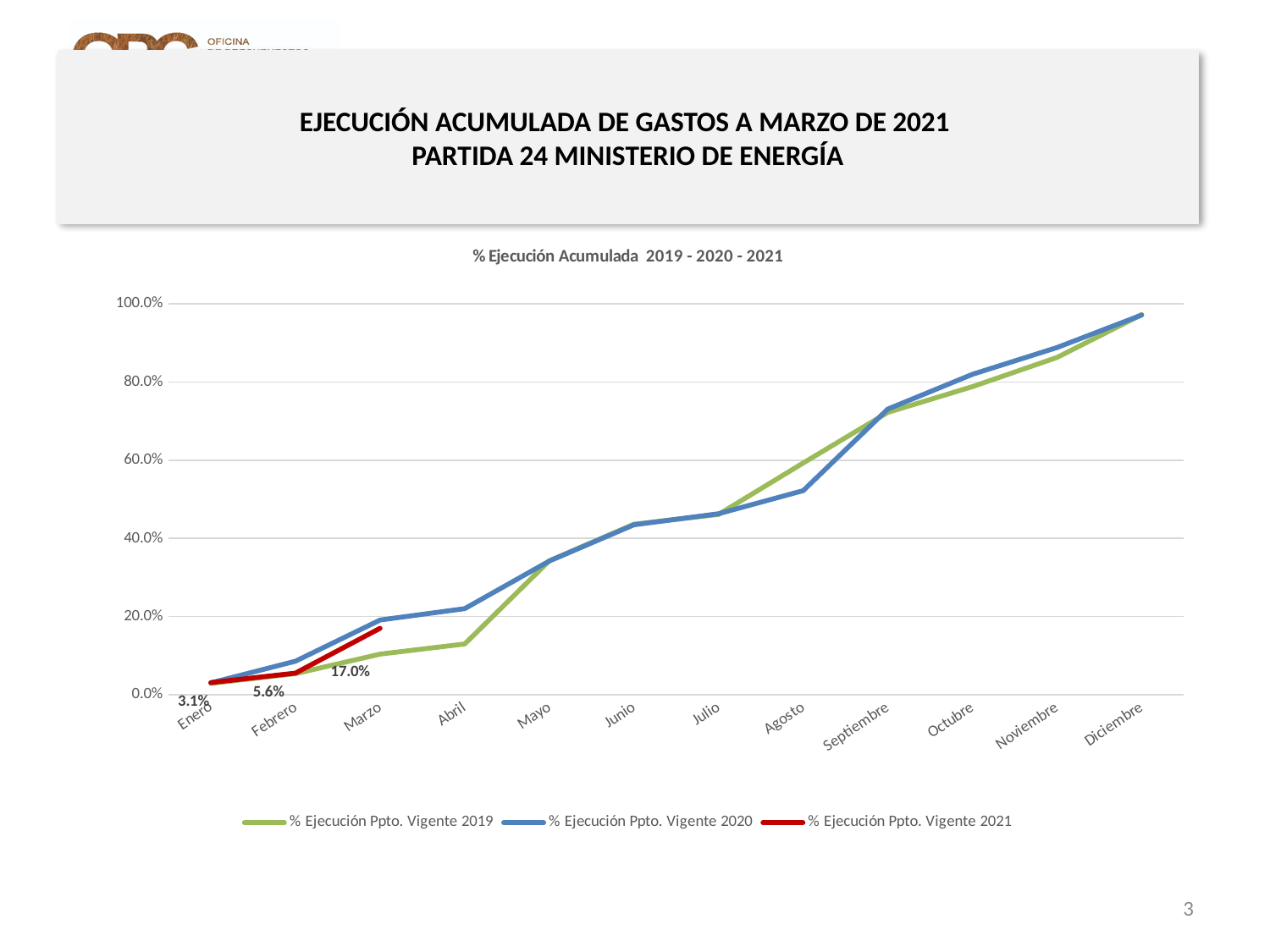
What kind of chart is shown on the slide? Line chart In Abril, which series has the larger value: % Ejecución Ppto. Vigente 2019 or % Ejecución Ppto. Vigente 2020? % Ejecución Ppto. Vigente 2020 Which month has the highest value for the % Ejecución Ppto. Vigente 2021 series? Marzo What is the title of the chart? % Ejecución Acumulada 2019 - 2020 - 2021 How many series does the legend list? 3 What is the difference between the 2021 values for Marzo and Febrero? 11.4% Do the values for % Ejecución Ppto. Vigente 2020 rise or fall from Enero to Diciembre? Rise How many months are shown on the x axis? 12 What is the value of % Ejecución Ppto. Vigente 2021 for Marzo? 17.0% What is the value of % Ejecución Ppto. Vigente 2021 for Febrero? 5.6% What is the value of % Ejecución Ppto. Vigente 2021 for Enero? 3.1% Is the value for % Ejecución Ppto. Vigente 2019 in Abril greater or less than 20.0%? less